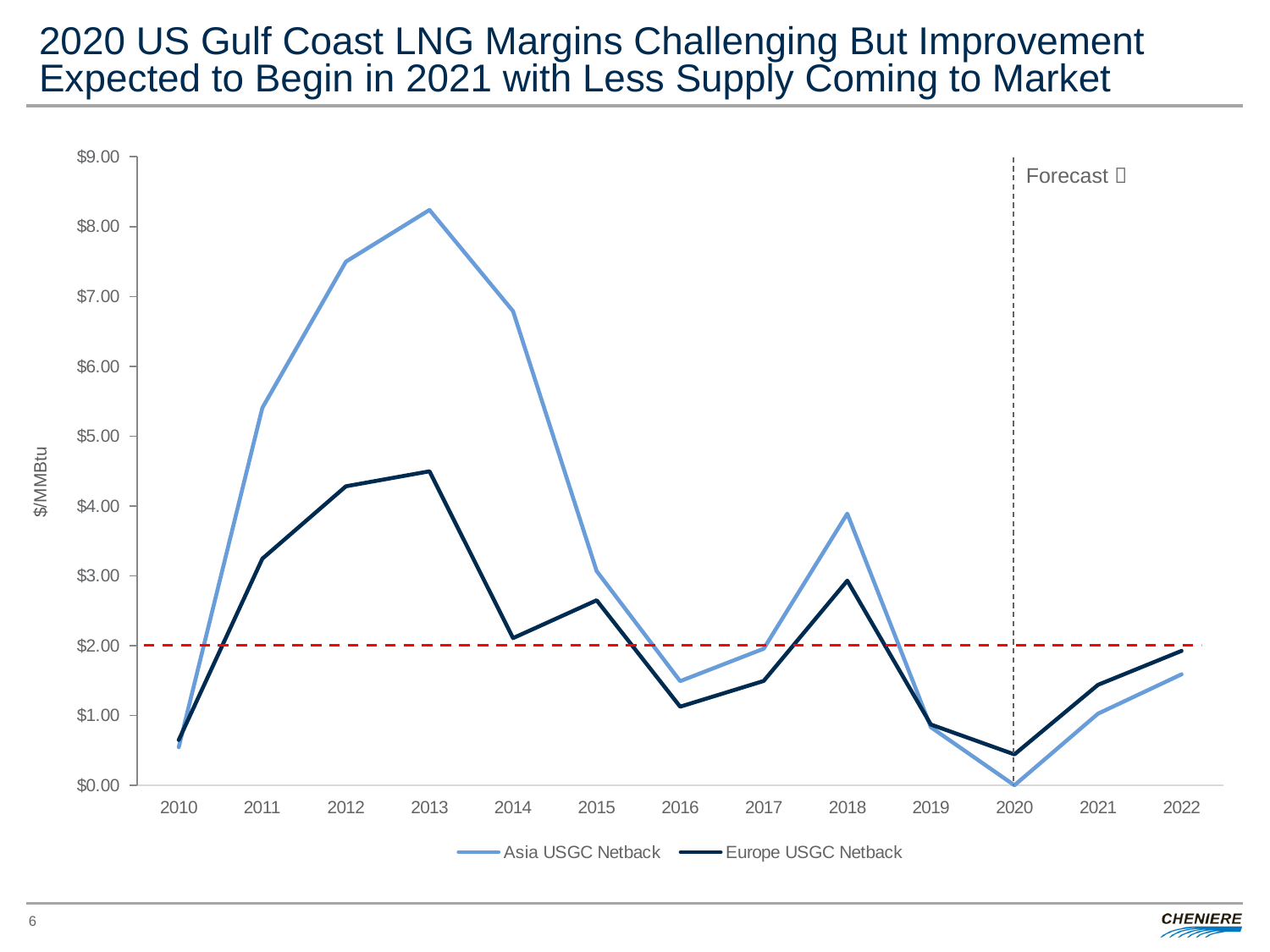
Which series has the higher value in 2012, Asia USGC Netback or Europe USGC Netback? Asia USGC Netback What kind of chart is shown on the slide? line chart Is the Europe USGC Netback in 2016 greater or less than $2.00? less In which year does the Asia USGC Netback reach its highest value? 2013 In which year does the Europe USGC Netback reach its highest value? 2013 What is the label on the y axis? $/MMBtu In which year is the Asia USGC Netback at its lowest? 2020 How many series does the legend list? 2 Is the Asia USGC Netback in 2018 greater or less than $3.00? greater Is the Asia USGC Netback in 2013 greater or less than $8.00? greater Which series has the higher value in 2021, Asia USGC Netback or Europe USGC Netback? Europe USGC Netback How many years are shown along the x axis? 13